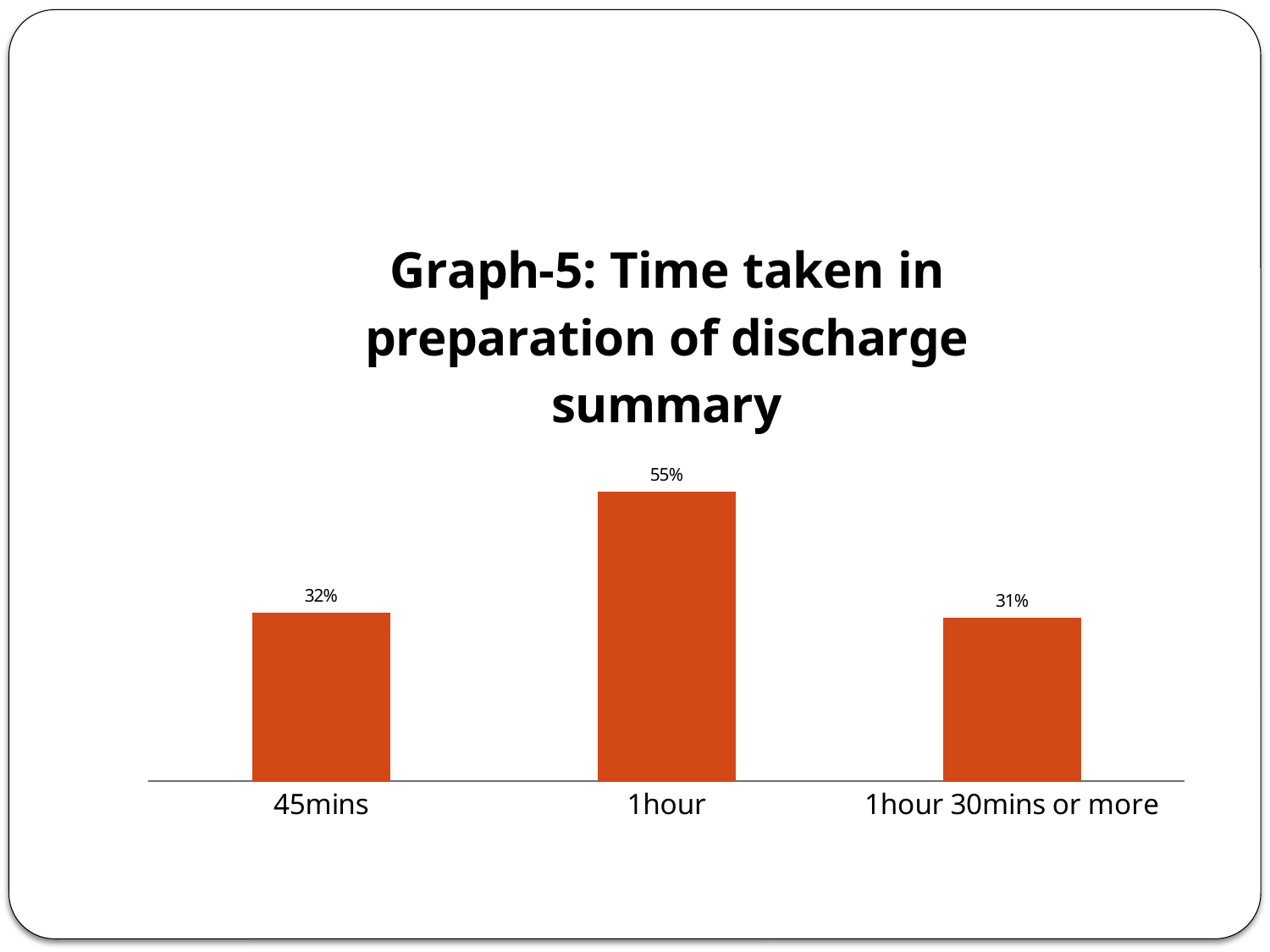
What kind of chart is shown on the slide? bar chart What is the difference between the values for 1hour and 45mins? 23% How many categories are shown on the x axis? 3 What is the difference between the values for 45mins and 1hour 30mins or more? 1% Which category has the lowest value? 1hour 30mins or more Which is larger, the value for 1hour or the value for 1hour 30mins or more? 1hour What is the title of the chart? Graph-5: Time taken in preparation of discharge summary What is the value for 45mins? 32% What is the value for 1hour? 55% Which category has the highest value? 1hour What is the value for 1hour 30mins or more? 31% What colour are the bars in the chart? orange